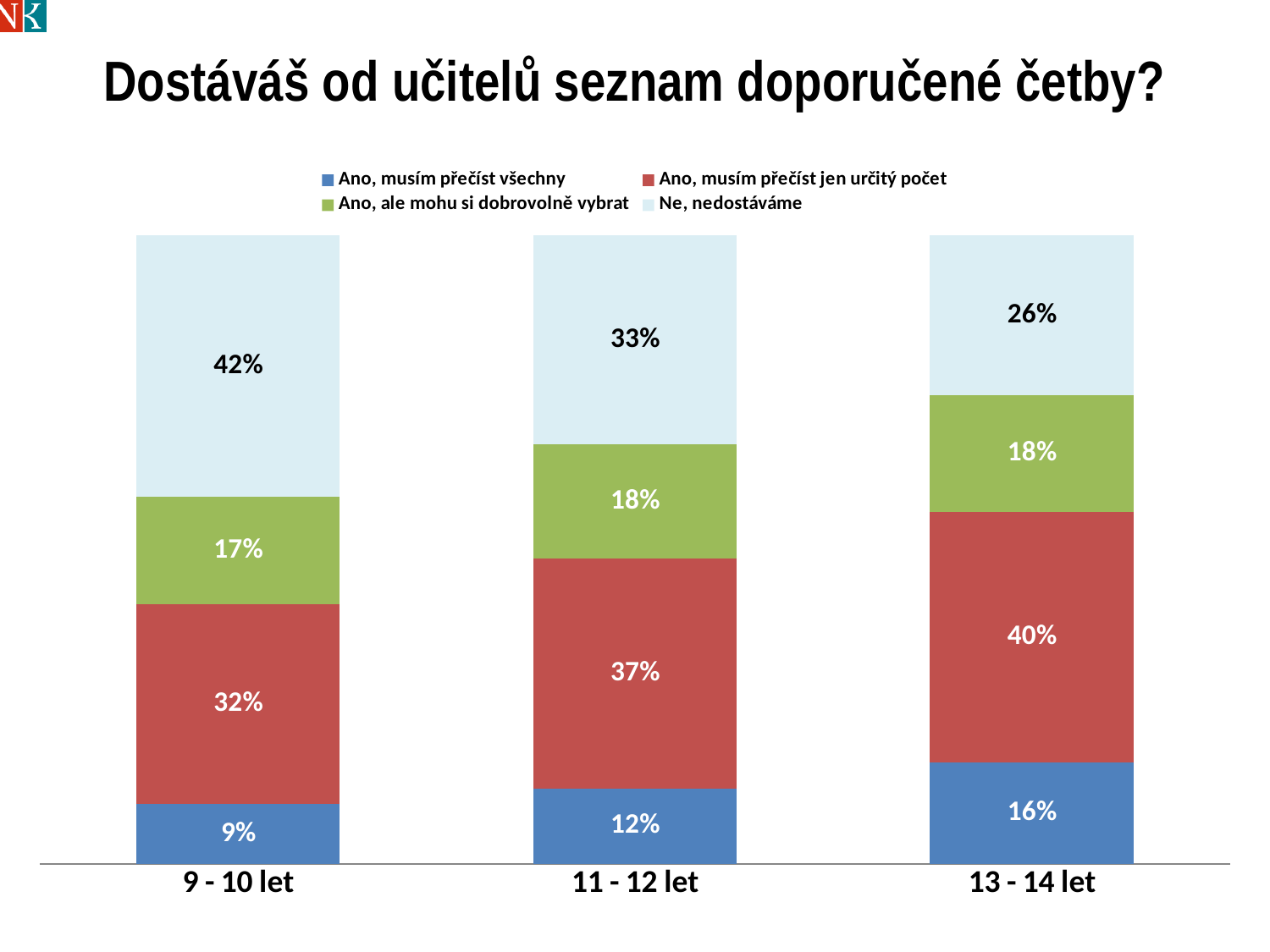
Which age group has the lowest share for "Ano, musím přečíst všechny"? 9 - 10 let What kind of chart is shown on the slide? Stacked bar chart How many age groups are shown on the x axis? 3 How many series does the legend list? 4 What percentage of the 9 - 10 let group answered "Ne, nedostáváme"? 42% What percentage of the 13 - 14 let group answered "Ano, musím přečíst všechny"? 16% What is the total of the stacked bar for 11 - 12 let? 100% Which is larger: the "Ne, nedostáváme" share for 11 - 12 let or for 13 - 14 let? 11 - 12 let What is the value for "Ano, musím přečíst jen určitý počet" in the 11 - 12 let group? 37% Which age group has the highest share for "Ne, nedostáváme"? 9 - 10 let What is the difference between the "Ano, musím přečíst jen určitý počet" values for 13 - 14 let and 9 - 10 let? 8 percentage points Does the "Ne, nedostáváme" share rise or fall from 9 - 10 let to 13 - 14 let? Fall